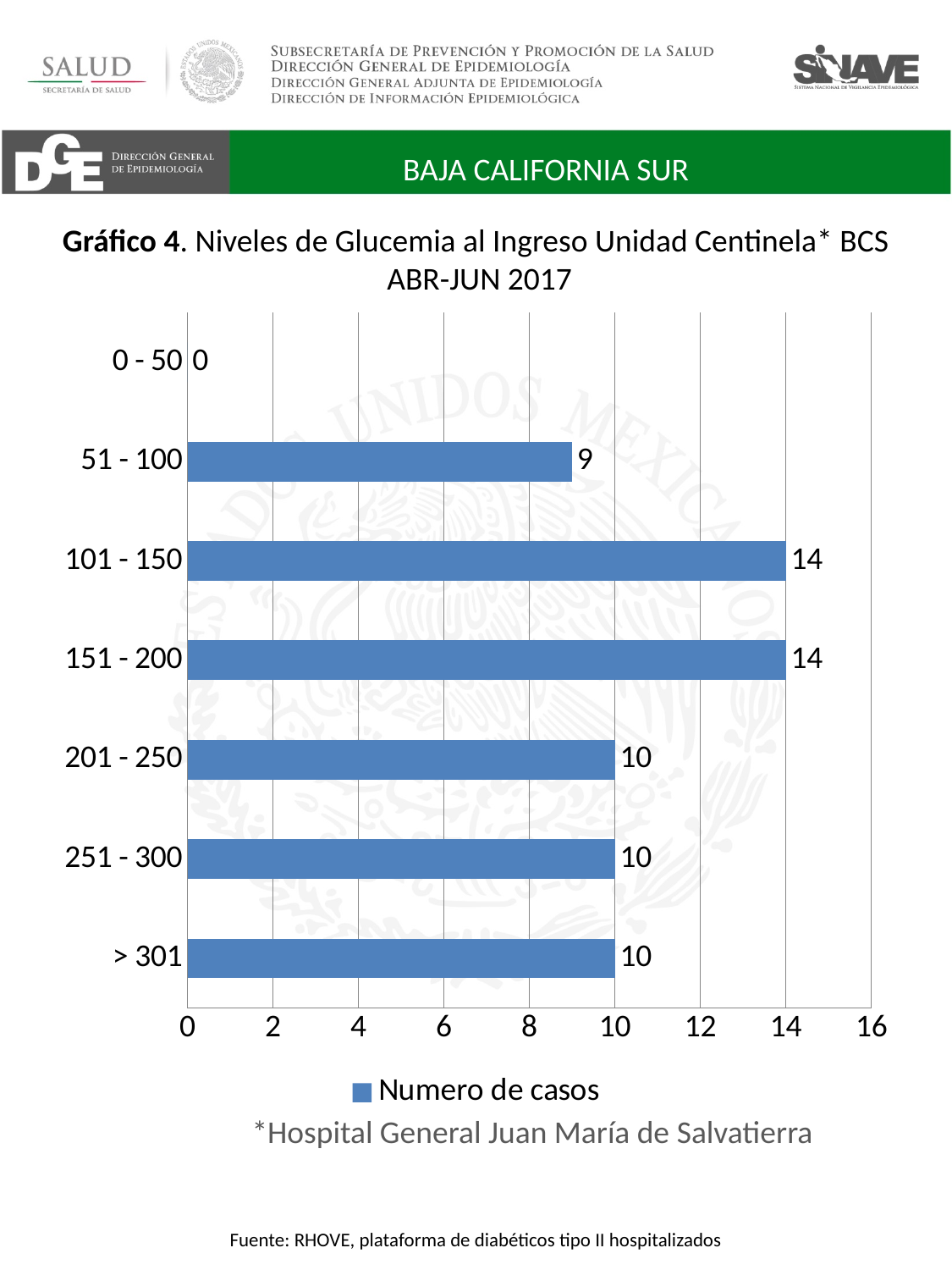
What is the number of cases for the 201 - 250 category? 10 What is the legend entry for the series shown in the chart? Numero de casos What is the highest number of cases shown for any category? 14 What is the number of cases for the 51 - 100 glucose level category? 9 What is the number of cases for the 0 - 50 category? 0 Which has more cases, the 151 - 200 category or the 251 - 300 category? 151 - 200 Which category has the lowest number of cases? 0 - 50 How many series does the legend list? 1 How many glucose level categories are shown on the chart? 7 What kind of chart is shown on the slide? Bar chart What is the difference in number of cases between the 101 - 150 category and the 51 - 100 category? 5 Is the value for the > 301 category greater or less than 8? greater